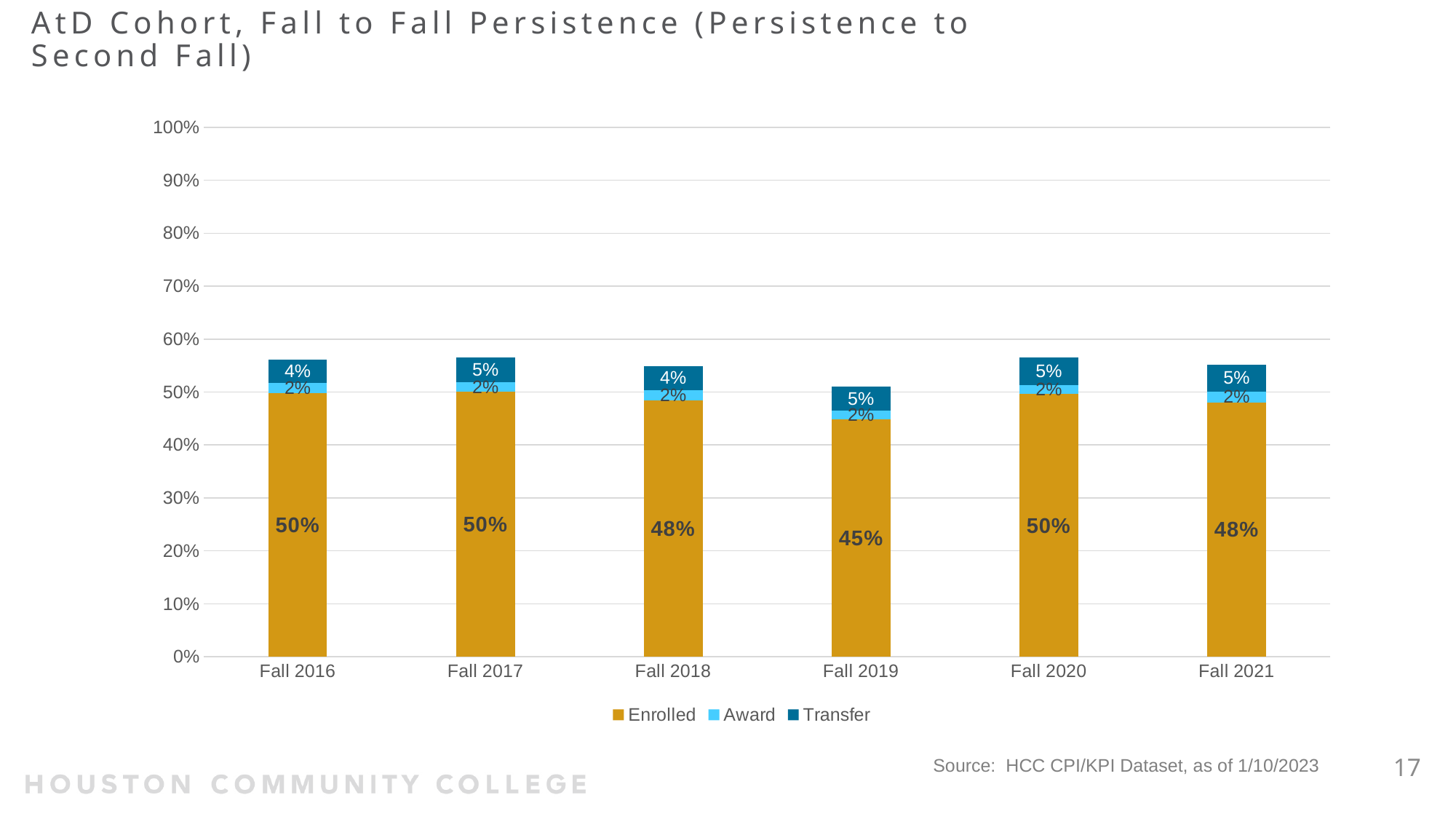
What is the difference between the Enrolled values for Fall 2017 and Fall 2019? 5% What is the Award value for Fall 2021? 2% Which cohort has the lowest Enrolled value? Fall 2019 Which is larger, the Enrolled value for Fall 2020 or for Fall 2021? Fall 2020 Which series is shown in the gold/orange colour? Enrolled What type of chart is shown on the slide? Stacked bar chart How many cohort categories are shown on the x axis? 6 What is the total of the stacked bar for Fall 2016? 56% What is the Transfer value for Fall 2017? 5% Which cohort has the lowest total stacked bar? Fall 2019 What is the Enrolled value for Fall 2019? 45% How many series does the legend list? 3